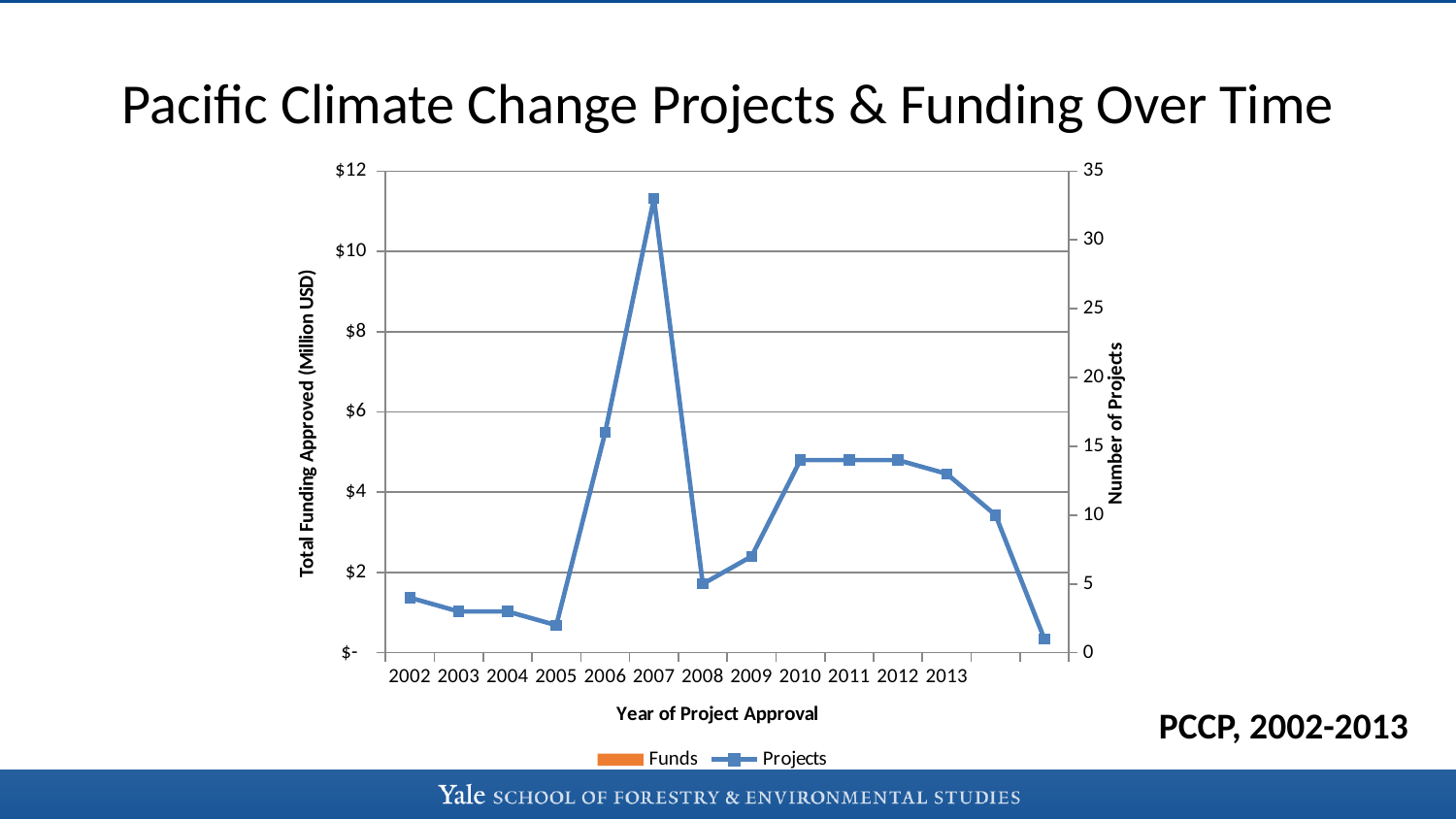
Does the number of projects rise or fall from 2002 to 2005? fall Is the number of projects in 2006 greater or less than 10? greater Which year has more projects, 2009 or 2010? 2010 What is the title of the right-hand vertical axis? Number of Projects Among the years 2002 to 2005, which year has the lowest number of projects? 2005 Is the number of projects in 2010 greater or less than 10? greater Is the number of projects in 2005 greater or less than 5? less Which year has more projects, 2006 or 2008? 2006 How many series does the legend list? 2 Which year has the highest number of projects? 2007 What kind of chart is shown on the slide? line chart